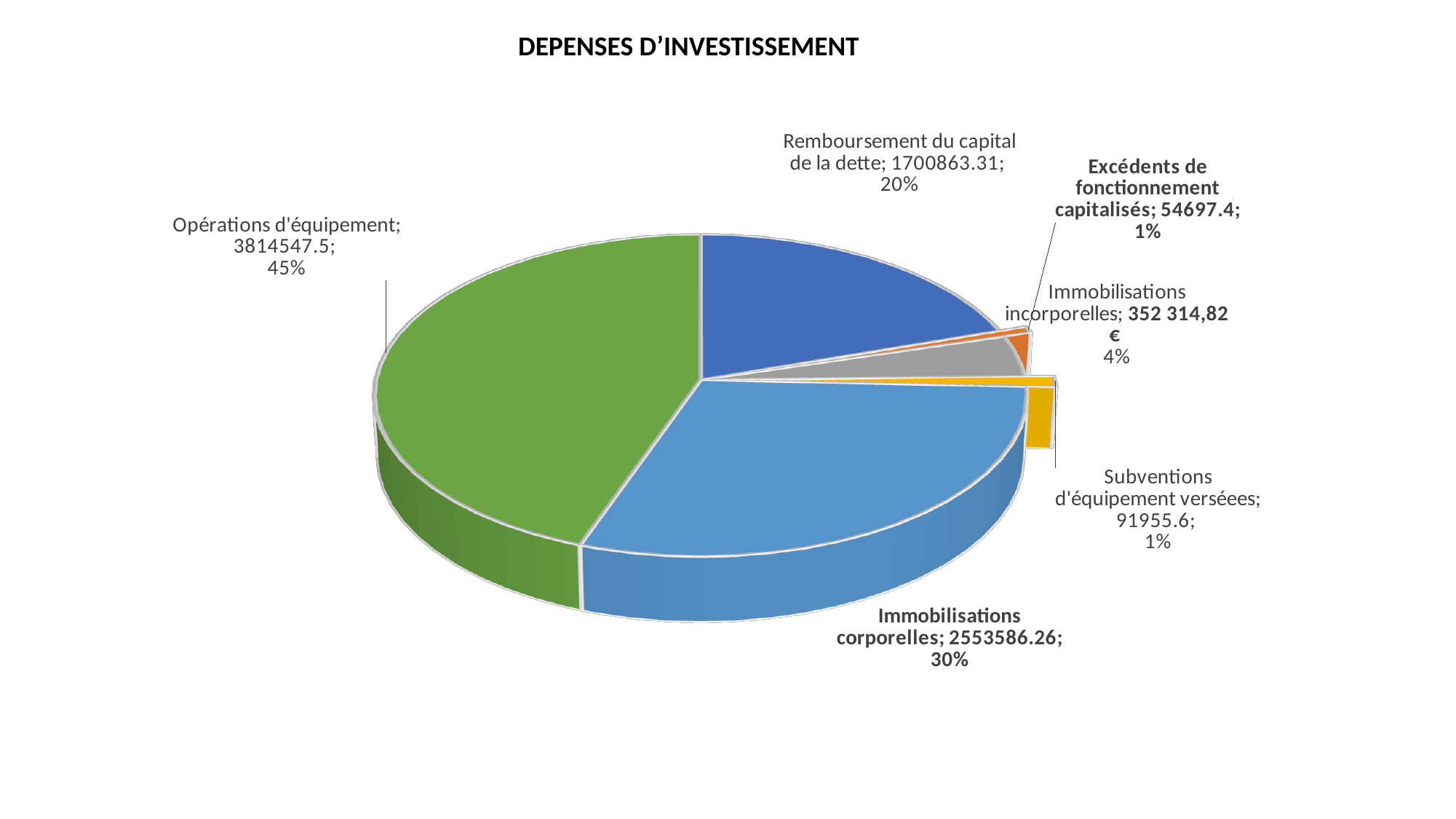
What is the value for Immobilisations incorporelles? 352 314,82 € Which is larger, the value for Remboursement du capital de la dette or the value for Immobilisations corporelles? Immobilisations corporelles Which category has the smallest value? Excédents de fonctionnement capitalisés What is the value for Subventions d'équipement versées? 91955.6 What is the value for Remboursement du capital de la dette? 1700863.31 What share of the pie does Immobilisations corporelles represent? 30% How many categories (slices) does the pie chart have? 6 What is the title of the chart? DEPENSES D'INVESTISSEMENT What type of chart is shown on the slide? Pie chart Which category has the largest share of the pie? Opérations d'équipement What is the difference between the values for Opérations d'équipement and Immobilisations corporelles? 1260961.24 What is the value for Opérations d'équipement? 3814547.5